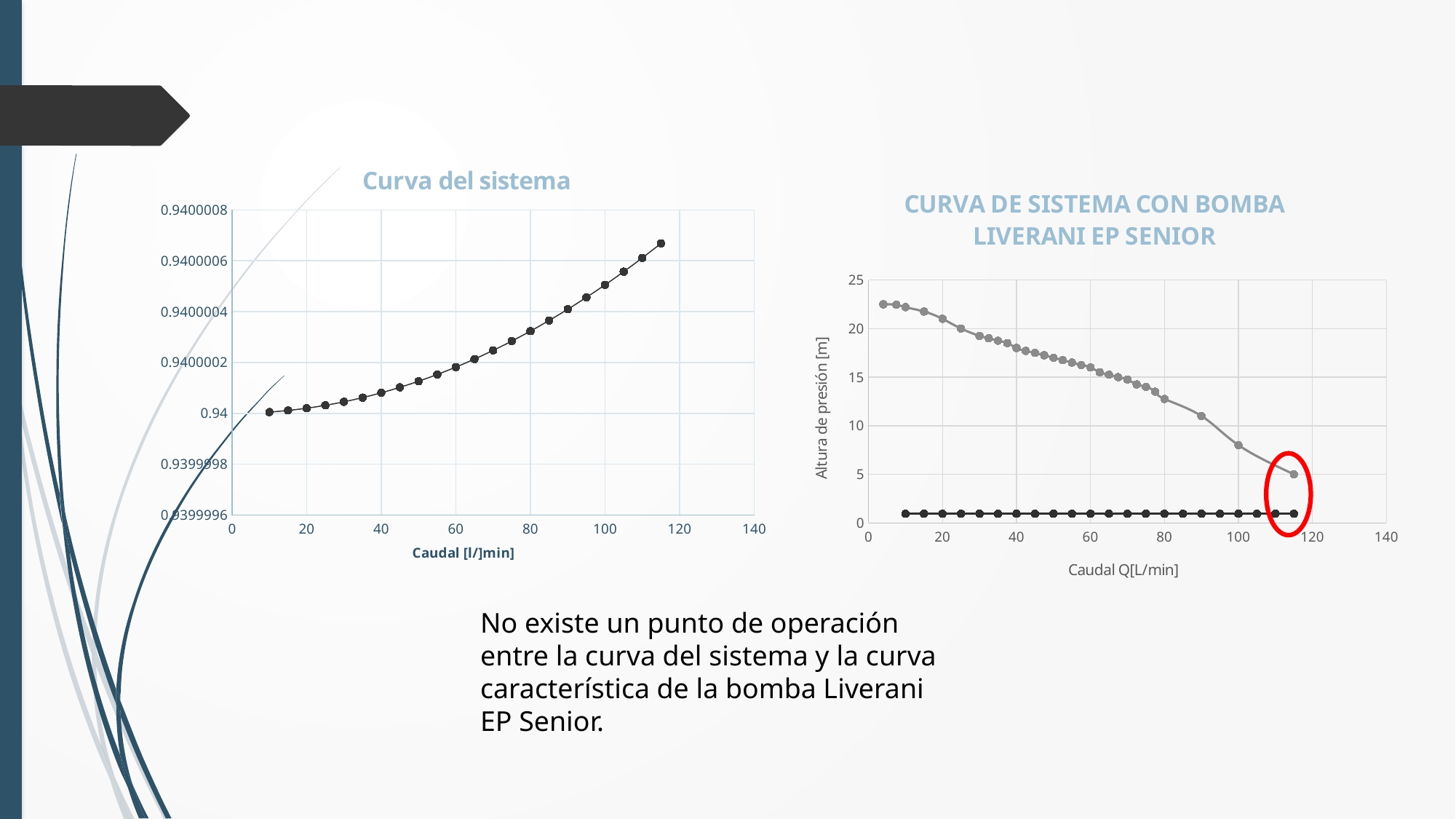
In the 'Curva del sistema' chart, do the values rise or fall as Caudal increases? rise In the 'Curva del sistema' chart, is the value at Caudal 80 greater or less than 0.9400004? less In the 'CURVA DE SISTEMA CON BOMBA LIVERANI EP SENIOR' chart, is the black line's value at Caudal 60 greater or less than 5? less What kind of chart is the 'Curva del sistema' chart on the left? line chart In the 'Curva del sistema' chart, is the value at Caudal 115 greater or less than 0.9400006? greater In the 'CURVA DE SISTEMA CON BOMBA LIVERANI EP SENIOR' chart, does the grey pump curve rise or fall as Caudal increases? fall In the 'CURVA DE SISTEMA CON BOMBA LIVERANI EP SENIOR' chart, at Caudal 40, which is larger: the grey curve or the black line? the grey curve What is the x-axis label of the 'Curva del sistema' chart? Caudal [l/]min] What is the y-axis label of the 'CURVA DE SISTEMA CON BOMBA LIVERANI EP SENIOR' chart? Altura de presión [m]